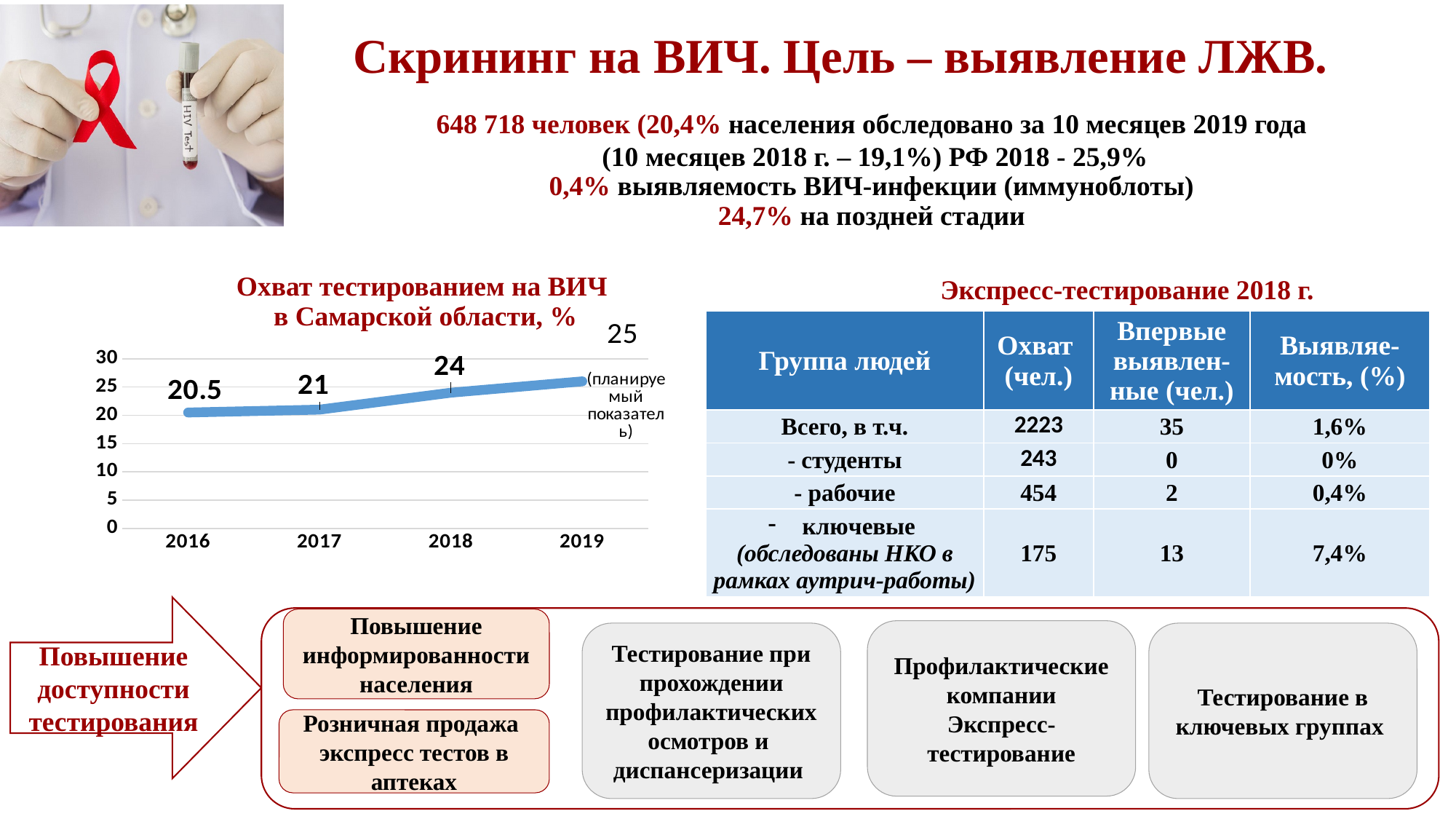
In the chart 'Охват тестированием на ВИЧ в Самарской области, %', which year has the lowest value? 2016 In the chart 'Охват тестированием на ВИЧ в Самарской области, %', what is the value for 2016? 20.5 In the chart 'Охват тестированием на ВИЧ в Самарской области, %', do the values rise or fall from 2016 to 2019? rise How many years are plotted in the chart 'Охват тестированием на ВИЧ в Самарской области, %'? 4 In the chart 'Охват тестированием на ВИЧ в Самарской области, %', which is larger, the value for 2017 or for 2018? 2018 What kind of chart is 'Охват тестированием на ВИЧ в Самарской области, %'? line chart In the chart 'Охват тестированием на ВИЧ в Самарской области, %', what is the planned value shown for 2019? 25 In the chart 'Охват тестированием на ВИЧ в Самарской области, %', what is the difference between the values for 2018 and 2016? 3.5 In the chart 'Охват тестированием на ВИЧ в Самарской области, %', what is the value for 2018? 24 In the chart 'Охват тестированием на ВИЧ в Самарской области, %', which year has the highest value? 2019 In the chart 'Охват тестированием на ВИЧ в Самарской области, %', is the value for 2017 greater or less than 25? less